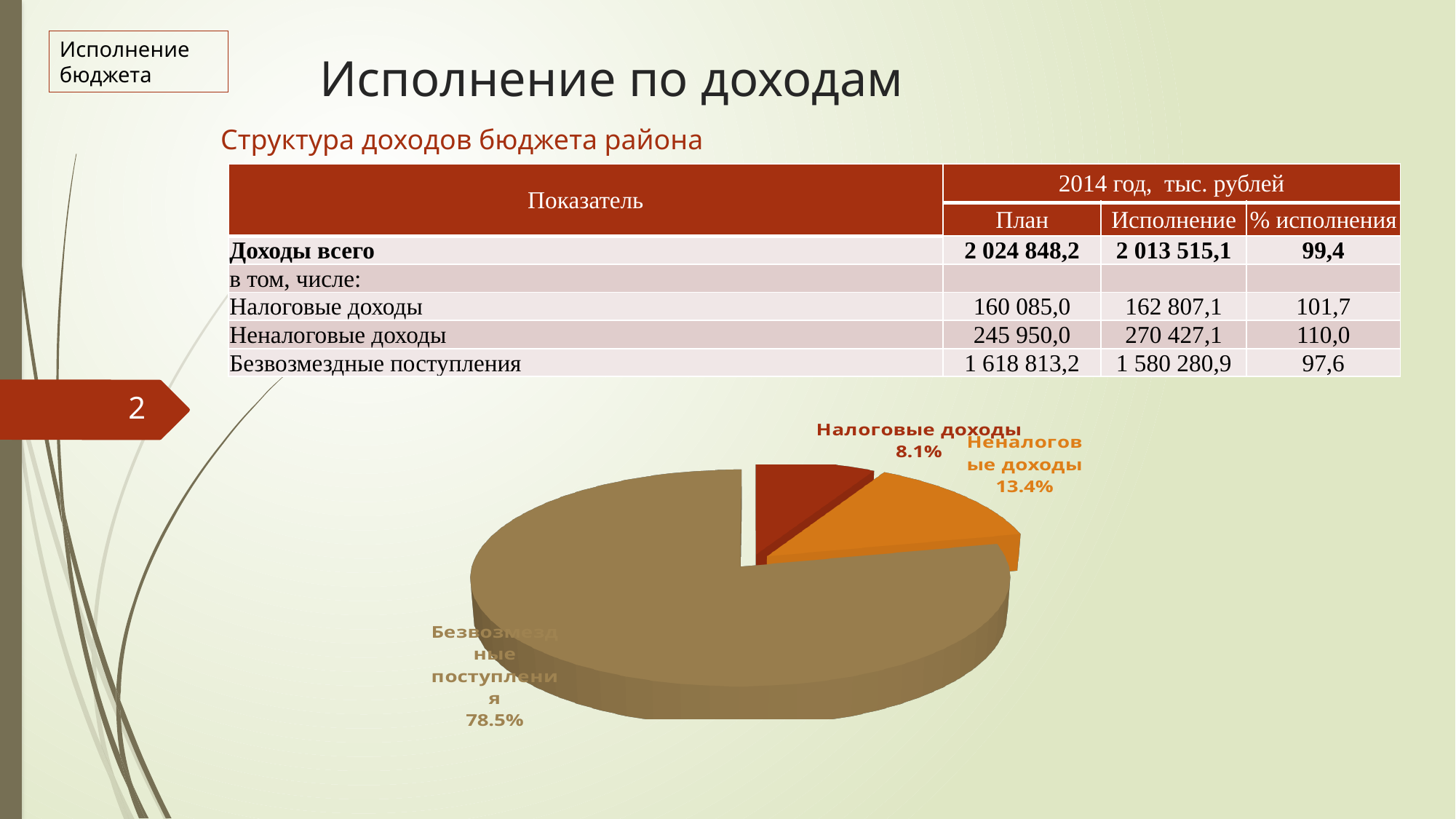
What share of the pie chart is labelled for Налоговые доходы? 8.1% How many slices does the pie chart have? 3 What is the difference in percentage points between the Неналоговые доходы slice and the Налоговые доходы slice? 5.3 What kind of chart is shown on the slide? Pie chart What share of the pie chart is labelled for Неналоговые доходы? 13.4% Which slice of the pie chart is the smallest? Налоговые доходы In the pie chart, which is larger: Неналоговые доходы or Налоговые доходы? Неналоговые доходы What is the difference in percentage points between the Безвозмездные поступления slice and the Неналоговые доходы slice? 65.1 What colour is the Безвозмездные поступления slice in the pie chart? Brown What share of the pie chart is labelled for Безвозмездные поступления? 78.5% Which slice of the pie chart is the largest? Безвозмездные поступления What colour is the Налоговые доходы slice in the pie chart? Dark red